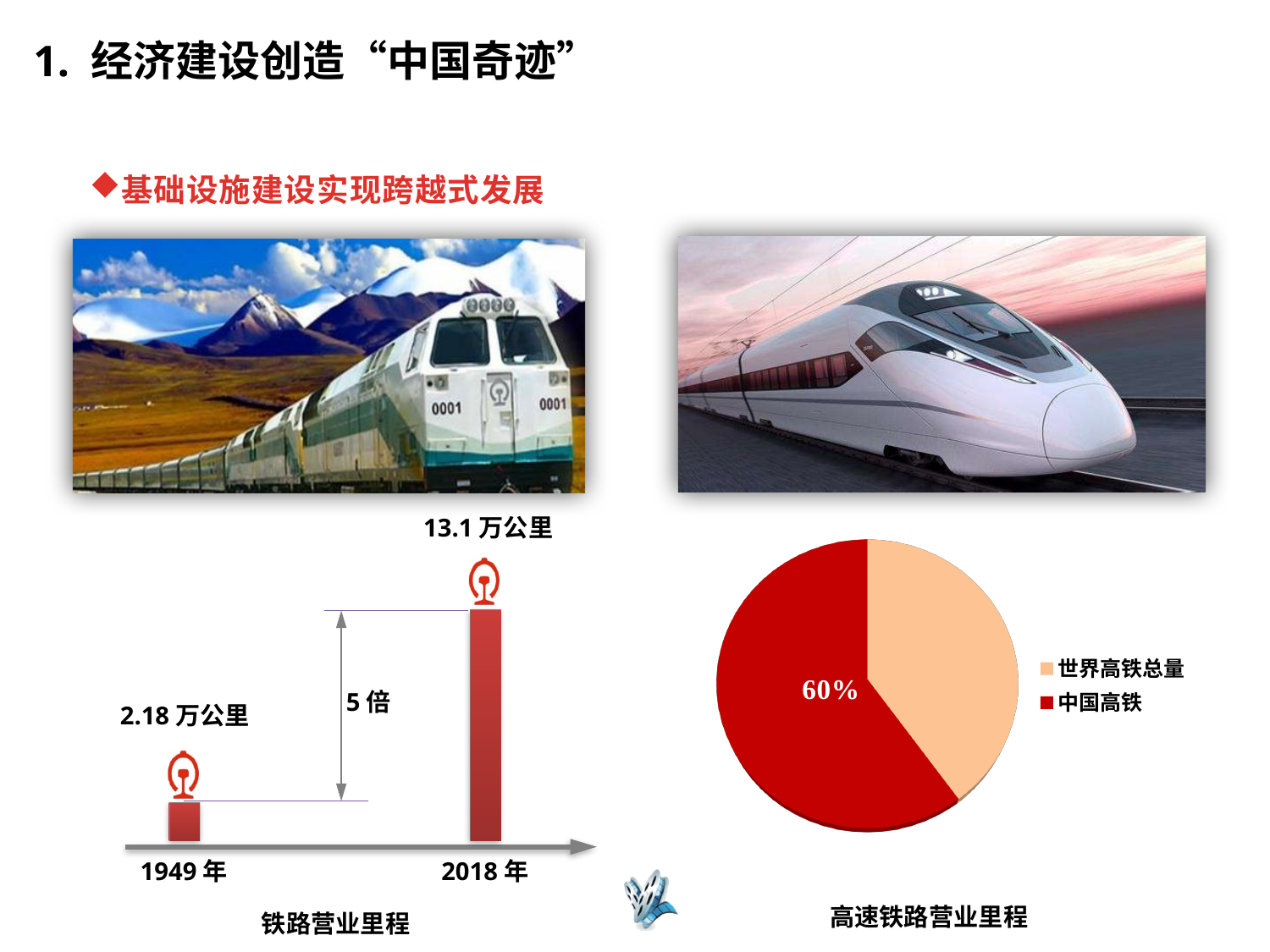
In the pie chart titled 高速铁路营业里程, what share is labelled on the 中国高铁 slice? 60% In the bar chart titled 铁路营业里程, what multiple is annotated between the 1949 年 and 2018 年 bars? 5 倍 In the bar chart titled 铁路营业里程, how many categories are shown on the x axis? 2 What kind of chart is the one titled 高速铁路营业里程? pie chart In the bar chart titled 铁路营业里程, which year has the higher value? 2018 年 In the pie chart titled 高速铁路营业里程, how many entries does the legend list? 2 What kind of chart is the one titled 铁路营业里程? bar chart In the pie chart titled 高速铁路营业里程, which legend entry is shown in red? 中国高铁 In the bar chart titled 铁路营业里程, what is the value for 1949 年? 2.18 万公里 In the bar chart titled 铁路营业里程, which year has the lower value? 1949 年 In the bar chart titled 铁路营业里程, do the values rise or fall from 1949 年 to 2018 年? rise In the bar chart titled 铁路营业里程, what is the value for 2018 年? 13.1 万公里